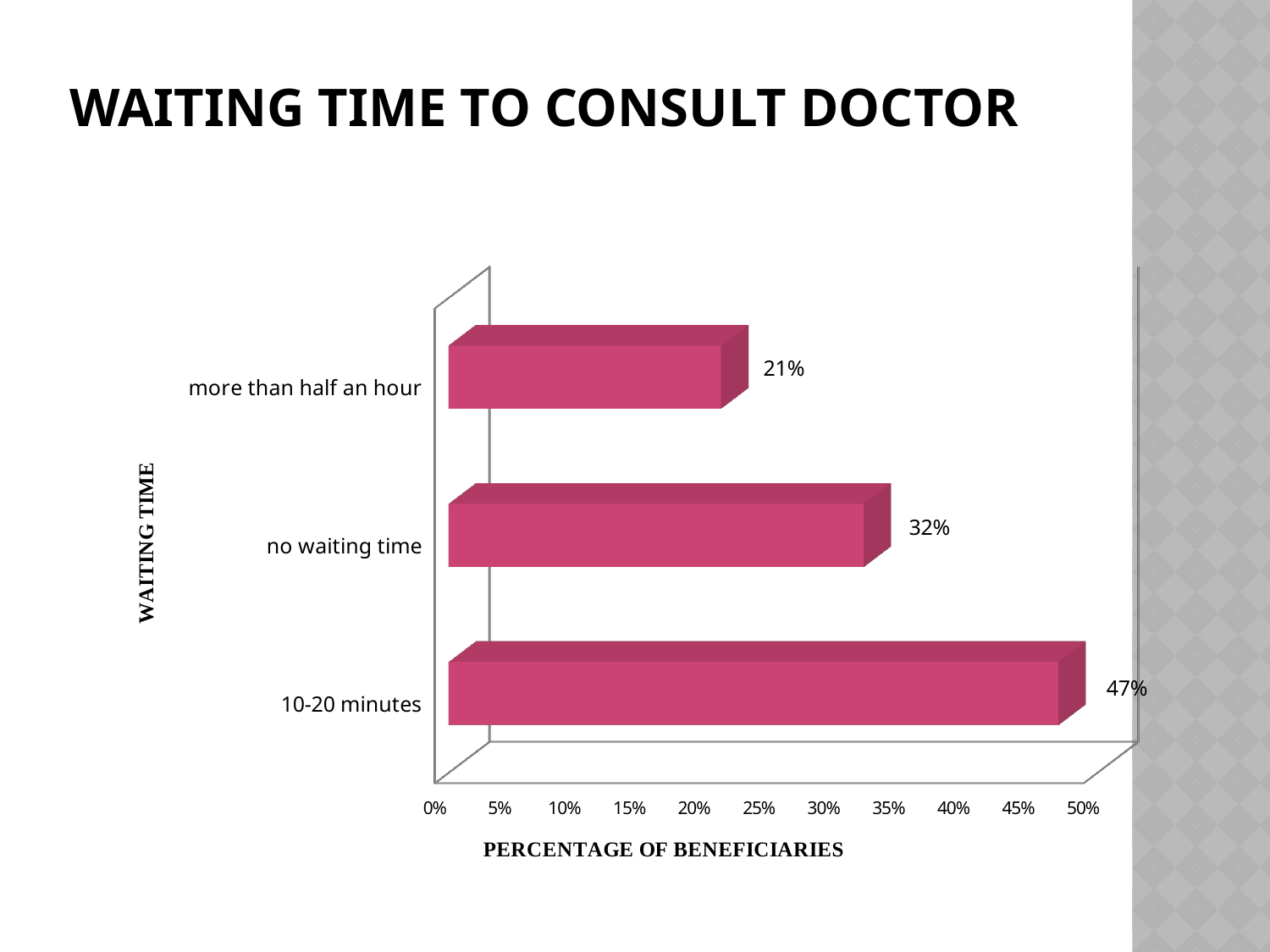
Which waiting time category has the highest percentage of beneficiaries? 10-20 minutes What type of chart is shown on the slide? bar chart What percentage of beneficiaries reported no waiting time? 32% What percentage of beneficiaries reported waiting more than half an hour? 21% Which waiting time category has the lowest percentage of beneficiaries? more than half an hour Is the value for 10-20 minutes greater or less than 45%? greater What is the difference in percentage points between the no waiting time category and the more than half an hour category? 11% What is the difference in percentage points between the 10-20 minutes category and the no waiting time category? 15% How many waiting time categories are shown in the chart? 3 What is the label of the horizontal axis of the chart? PERCENTAGE OF BENEFICIARIES Which has a larger percentage of beneficiaries: no waiting time or more than half an hour? no waiting time What percentage of beneficiaries reported a waiting time of 10-20 minutes? 47%